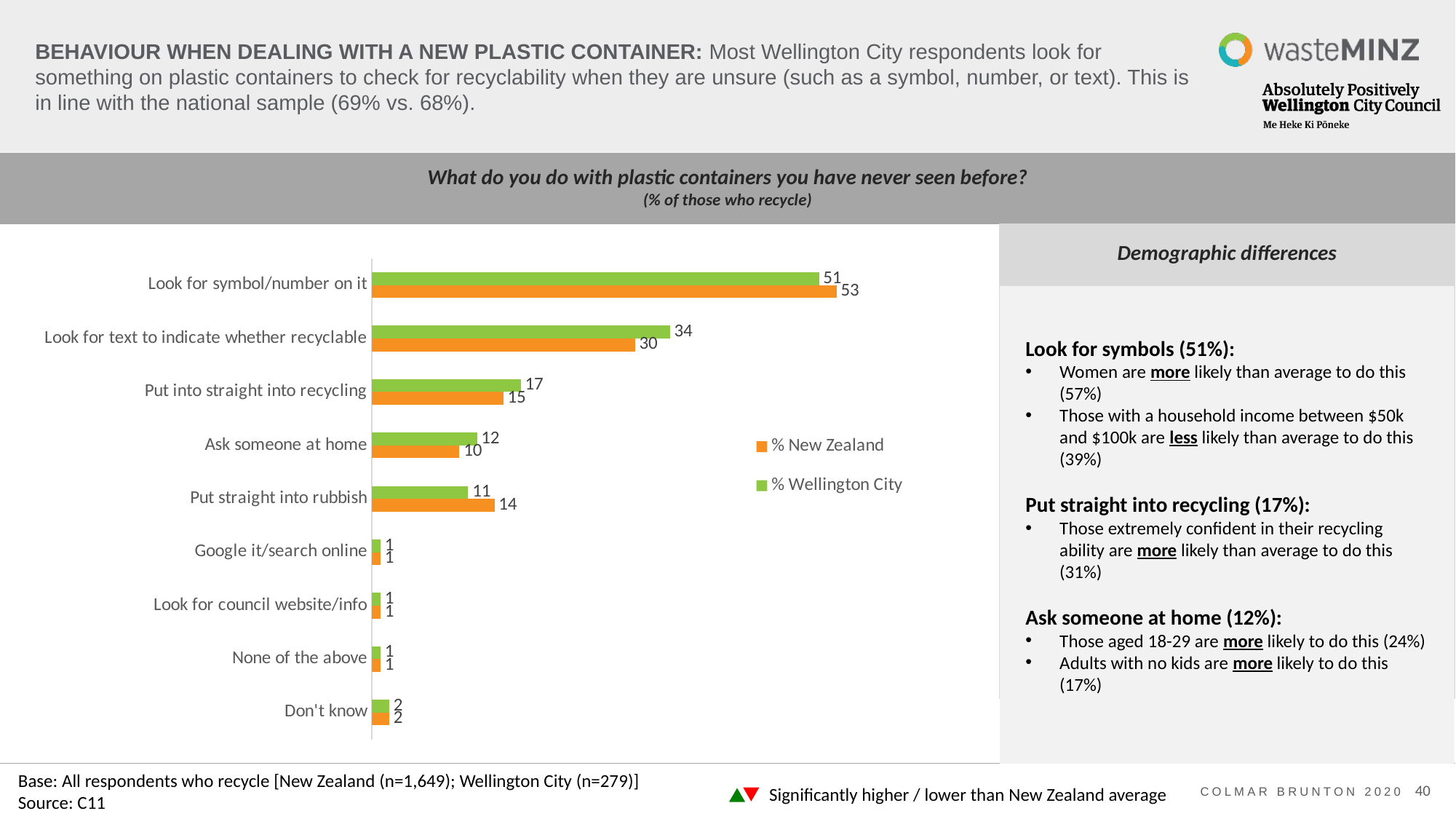
How many categories are shown on the chart? 9 What is the % Wellington City value for "Look for symbol/number on it"? 51 What is the % New Zealand value for "Look for text to indicate whether recyclable"? 30 Which is larger for "Ask someone at home": the % New Zealand value or the % Wellington City value? % Wellington City Which category has the highest % Wellington City value? Look for symbol/number on it What is the difference between the % New Zealand and % Wellington City values for "Put into straight into recycling"? 2 Which colour represents % New Zealand in the chart? Orange Which is larger for "Put straight into rubbish": the % New Zealand value or the % Wellington City value? % New Zealand How many series does the legend list? 2 What kind of chart is shown on the slide? Bar chart What is the % Wellington City value for "Don't know"? 2 What is the % New Zealand value for "Put straight into rubbish"? 14